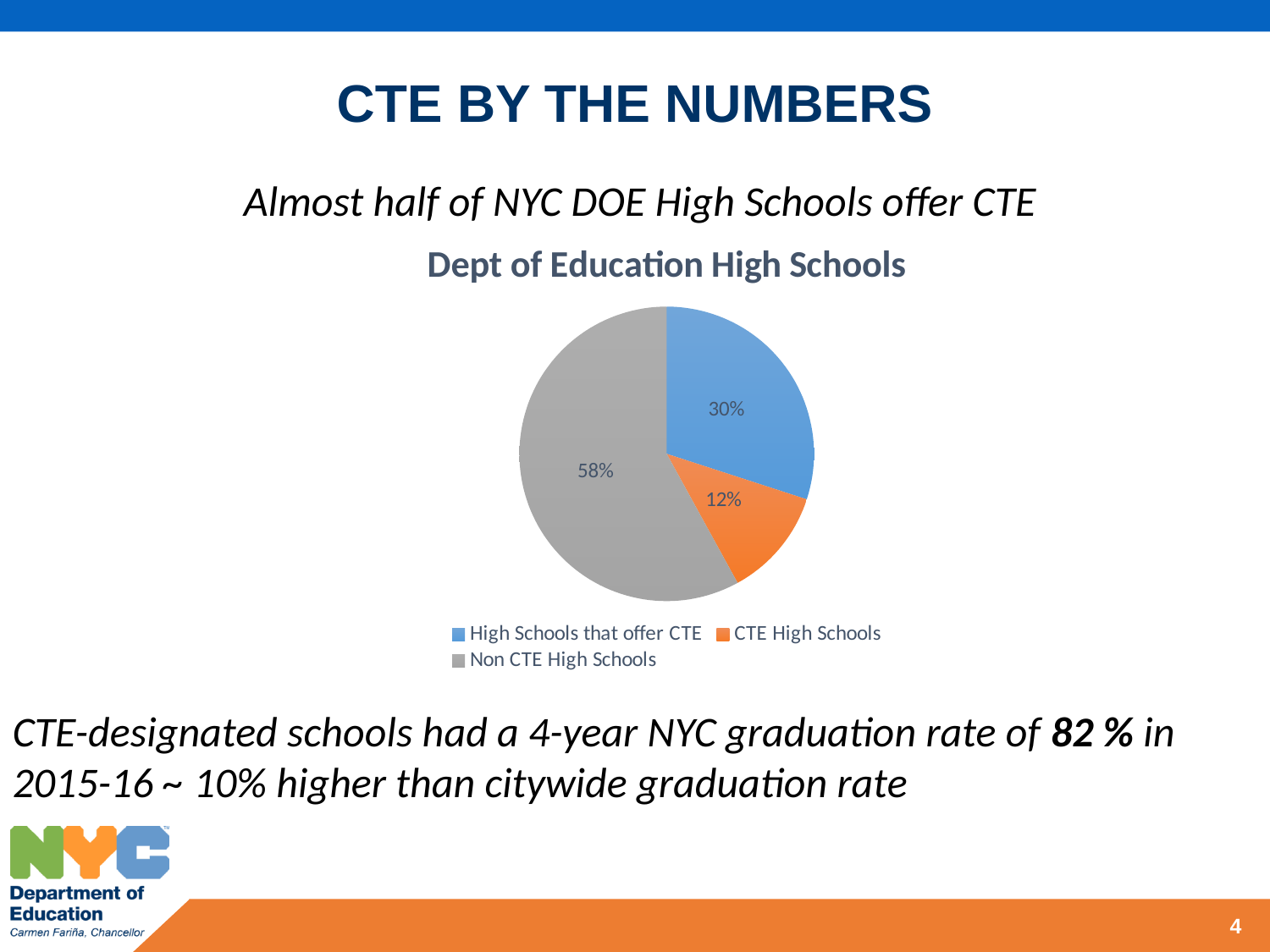
Which slice is larger: High Schools that offer CTE or CTE High Schools? High Schools that offer CTE What percentage of the pie is labelled for High Schools that offer CTE? 30% What percentage of the pie is labelled for CTE High Schools? 12% Which category has the smallest slice of the pie? CTE High Schools What kind of chart is shown on the slide? pie chart How many slices does the pie chart have? 3 What percentage of the pie is labelled for Non CTE High Schools? 58% How many entries does the legend list? 3 What colour is the slice for Non CTE High Schools? grey What is the chart's title? Dept of Education High Schools Which category has the largest slice of the pie? Non CTE High Schools What is the difference in percentage points between the Non CTE High Schools slice and the High Schools that offer CTE slice? 28